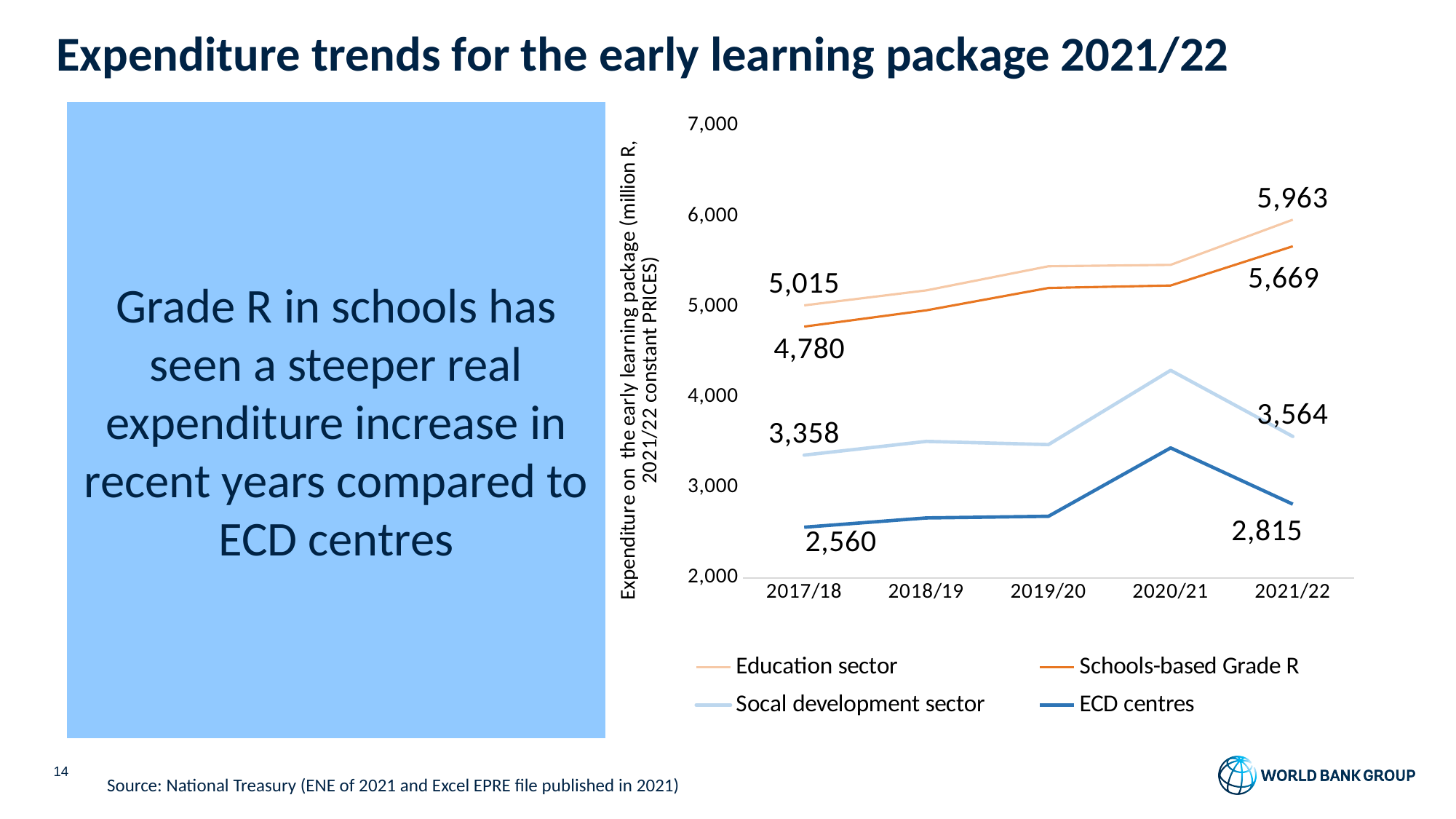
What is the value for ECD centres in 2021/22? 2,815 What is the value for the Social development sector in 2017/18? 3,358 What type of chart is shown on the slide? line chart Is the value for ECD centres in 2020/21 greater or less than 3,000? greater Which series has the highest value in 2021/22? Education sector How many years are shown on the x axis? 5 What is the value for the Education sector in 2021/22? 5,963 How many series does the legend list? 4 What is the value for Schools-based Grade R in 2017/18? 4,780 What is the difference between the Schools-based Grade R values in 2021/22 and 2017/18? 889 Which series has the lowest value in 2017/18? ECD centres Does the Schools-based Grade R line rise or fall from 2017/18 to 2021/22? rise